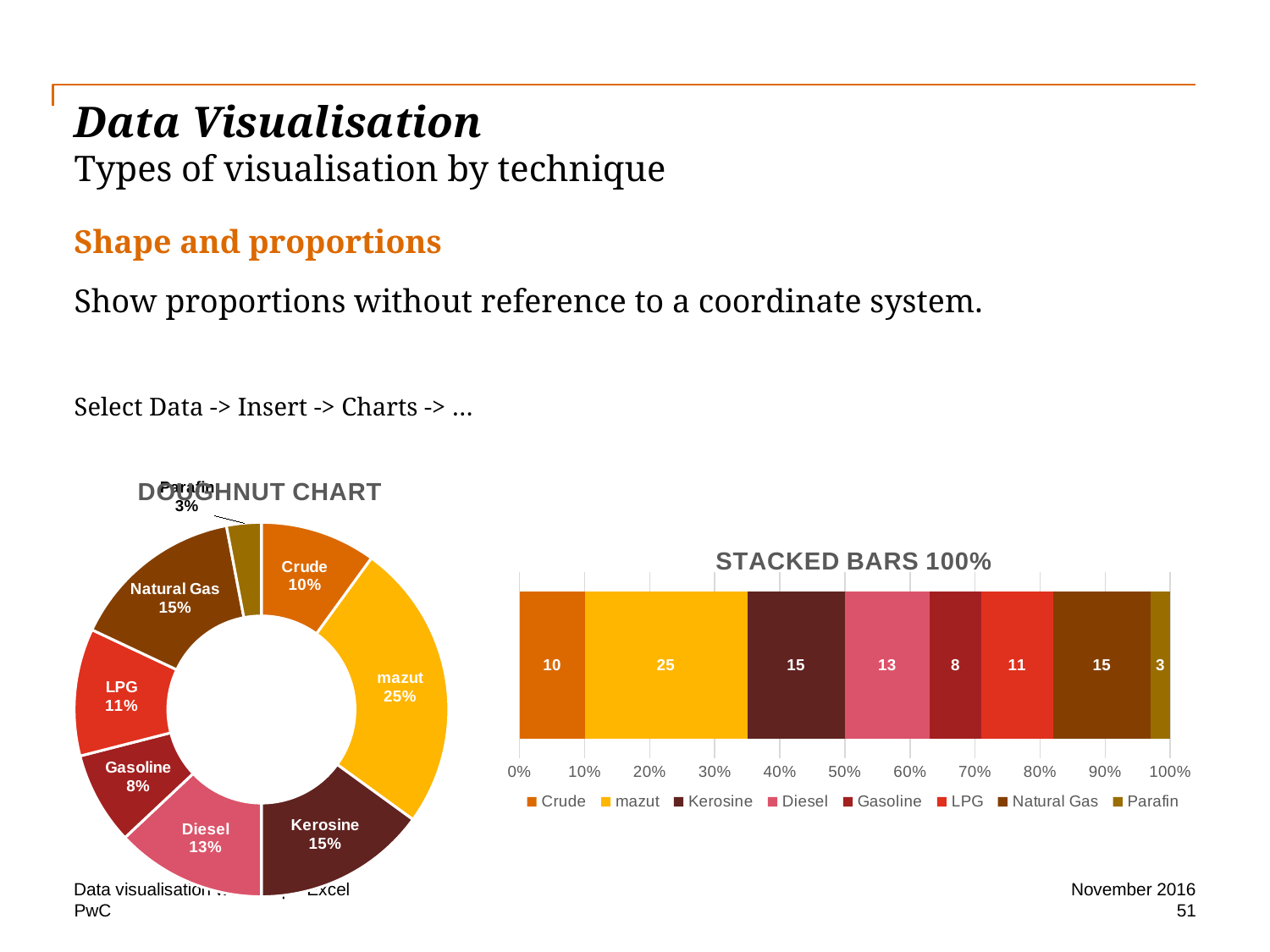
In the DOUGHNUT CHART, which is larger, the share for LPG or the share for Gasoline? LPG In the STACKED BARS 100% chart, what is the difference between the values for mazut and Crude? 15 In the DOUGHNUT CHART, what share does mazut have? 25% In the DOUGHNUT CHART, what share does Diesel have? 13% In the DOUGHNUT CHART, which category has the largest share? mazut In the STACKED BARS 100% chart, what is the value for Gasoline? 8 In the DOUGHNUT CHART, how many categories are shown? 8 In the DOUGHNUT CHART, which category has the smallest share? Parafin In the STACKED BARS 100% chart, what is the value for Kerosine? 15 What type of chart is the chart on the right side of the slide? Stacked bar chart In the STACKED BARS 100% chart, what is the total of all the segments in the bar? 100 In the STACKED BARS 100% chart, how many series does the legend list? 8